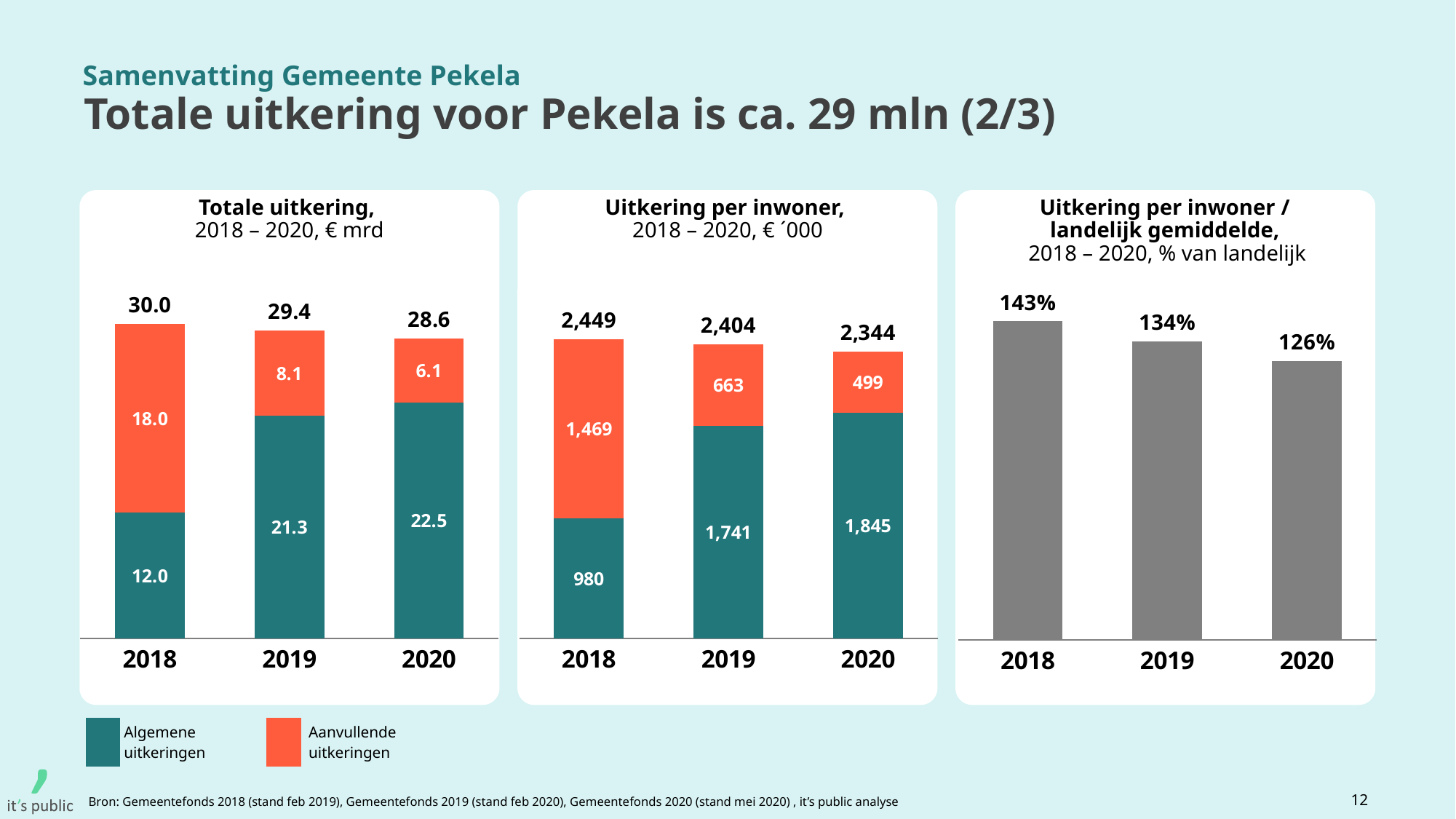
In the 'Totale uitkering' chart, do the total values rise or fall from 2018 to 2020? fall In the 'Uitkering per inwoner' chart, what is the value of Algemene uitkeringen in 2018? 980 What kind of chart is the 'Uitkering per inwoner / landelijk gemiddelde' chart? bar chart In the 'Totale uitkering' chart, what is the value of Algemene uitkeringen in 2020? 22.5 How many series does the legend list for the stacked bar charts? 2 In the 'Uitkering per inwoner / landelijk gemiddelde' chart, what is the value for 2019? 134% In the 'Totale uitkering' chart, which year has the lowest total? 2020 In the 'Totale uitkering' chart, what is the total value for 2018? 30.0 In the 'Uitkering per inwoner' chart, what is the difference between the Aanvullende uitkeringen values for 2018 and 2020? 970 In the 'Uitkering per inwoner / landelijk gemiddelde' chart, which year has the highest value? 2018 In the 'Totale uitkering' chart, what is the value of Aanvullende uitkeringen in 2019? 8.1 In the 'Uitkering per inwoner' chart, what is the total value for 2020? 2,344